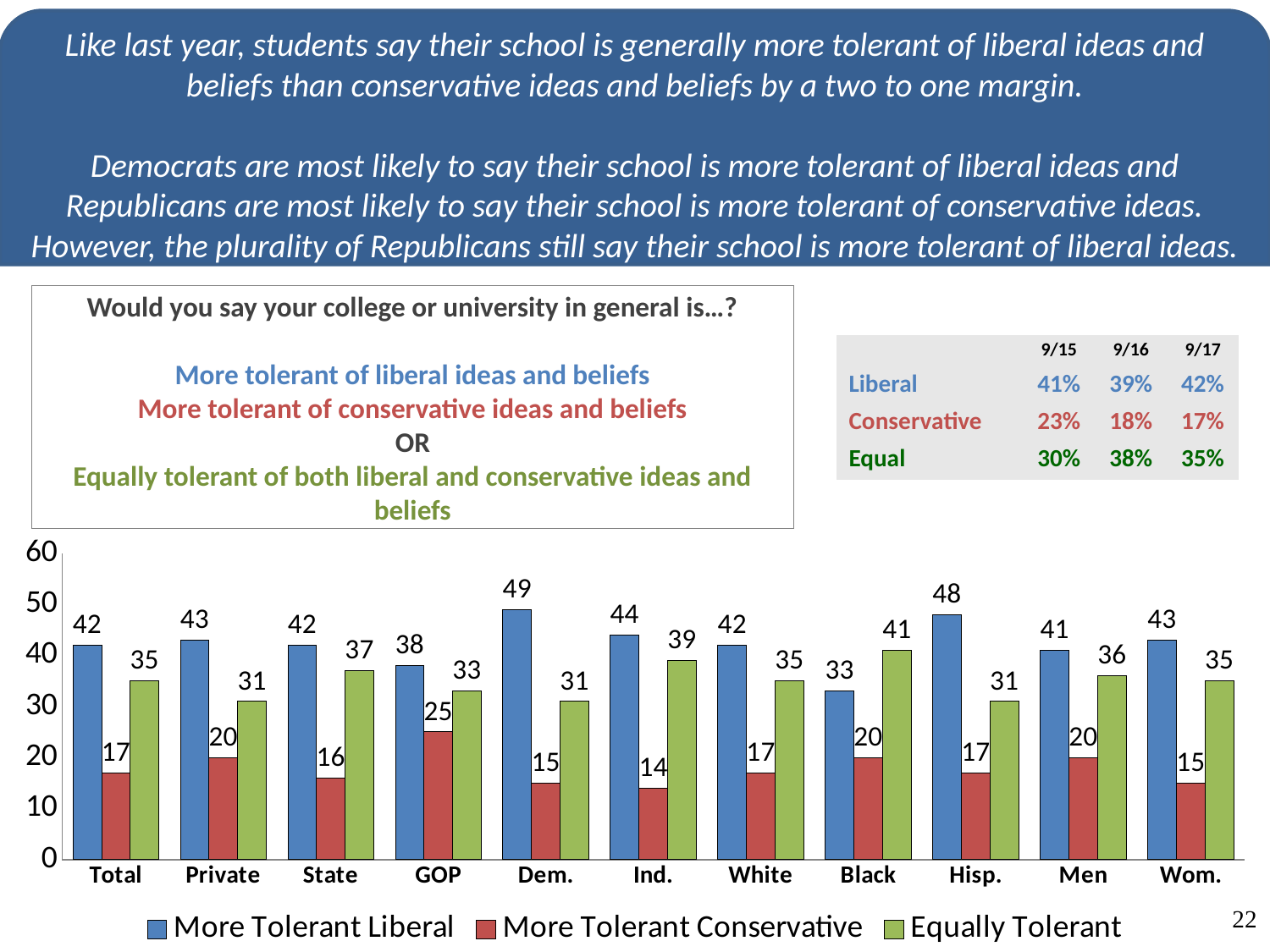
Which category has the highest More Tolerant Liberal value? Dem. What is the value for More Tolerant Liberal for Dem.? 49 What is the difference between the More Tolerant Liberal values for Dem. and GOP? 11 What is the value for More Tolerant Conservative for GOP? 25 What kind of chart is shown at the bottom of the slide? Bar chart How many categories are shown on the x axis of the bar chart? 11 Which colour represents the Equally Tolerant series in the bar chart? Green What is the difference between the More Tolerant Liberal and Equally Tolerant values for Total? 7 Which is larger for Black: More Tolerant Liberal or Equally Tolerant? Equally Tolerant What is the value for Equally Tolerant for Black? 41 How many series does the legend of the bar chart list? 3 Which category has the lowest More Tolerant Conservative value? Ind.